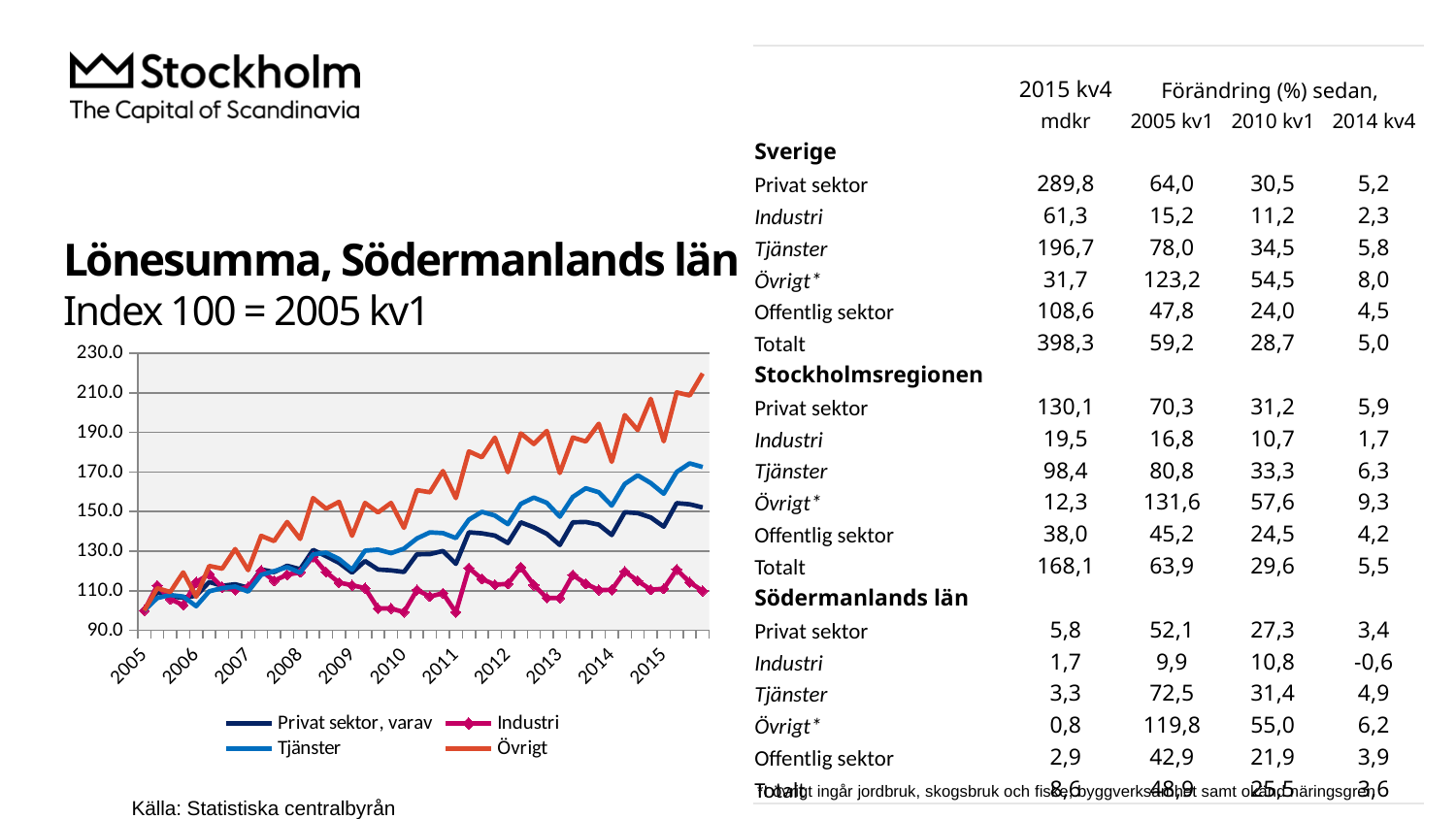
What is the index base stated under the chart title? Index 100 = 2005 kv1 Does the Övrigt series rise or fall overall from 2005 to 2015? rise Is the value for Industri at the end of 2015 greater or less than 130? less What kind of chart is shown on the slide? line chart How many series does the chart legend list? 4 Is the value for Övrigt at the end of 2015 greater or less than 190? greater Is the value for Tjänster at the end of 2015 greater or less than 150? greater At the end of 2015, which is larger: Tjänster or Industri? Tjänster What is the title of the chart? Lönesumma, Södermanlands län Which series has the highest value at the end of 2015? Övrigt Which series has the lowest value at the end of 2015? Industri